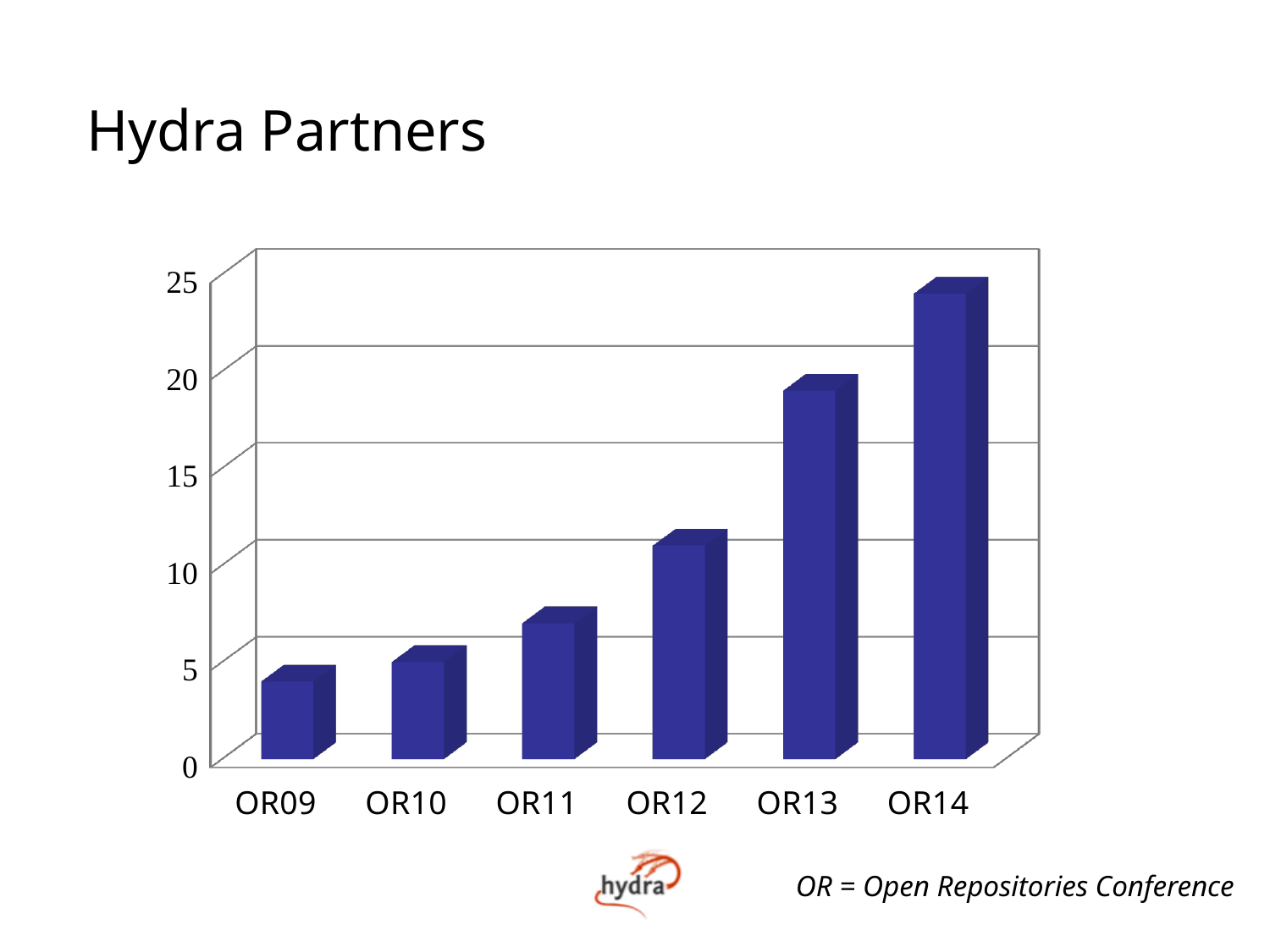
Which category has the highest value in the chart? OR14 What kind of chart is shown on the slide? bar chart Do the values rise or fall from OR09 to OR14? rise How many categories are shown on the x axis of the chart? 6 Is the value for OR11 greater or less than 10? less Is the value for OR13 greater or less than 15? greater What is the title of the slide containing the chart? Hydra Partners Is the value for OR14 greater or less than 20? greater Which is larger, the value for OR13 or the value for OR12? OR13 Which category has the lowest value in the chart? OR09